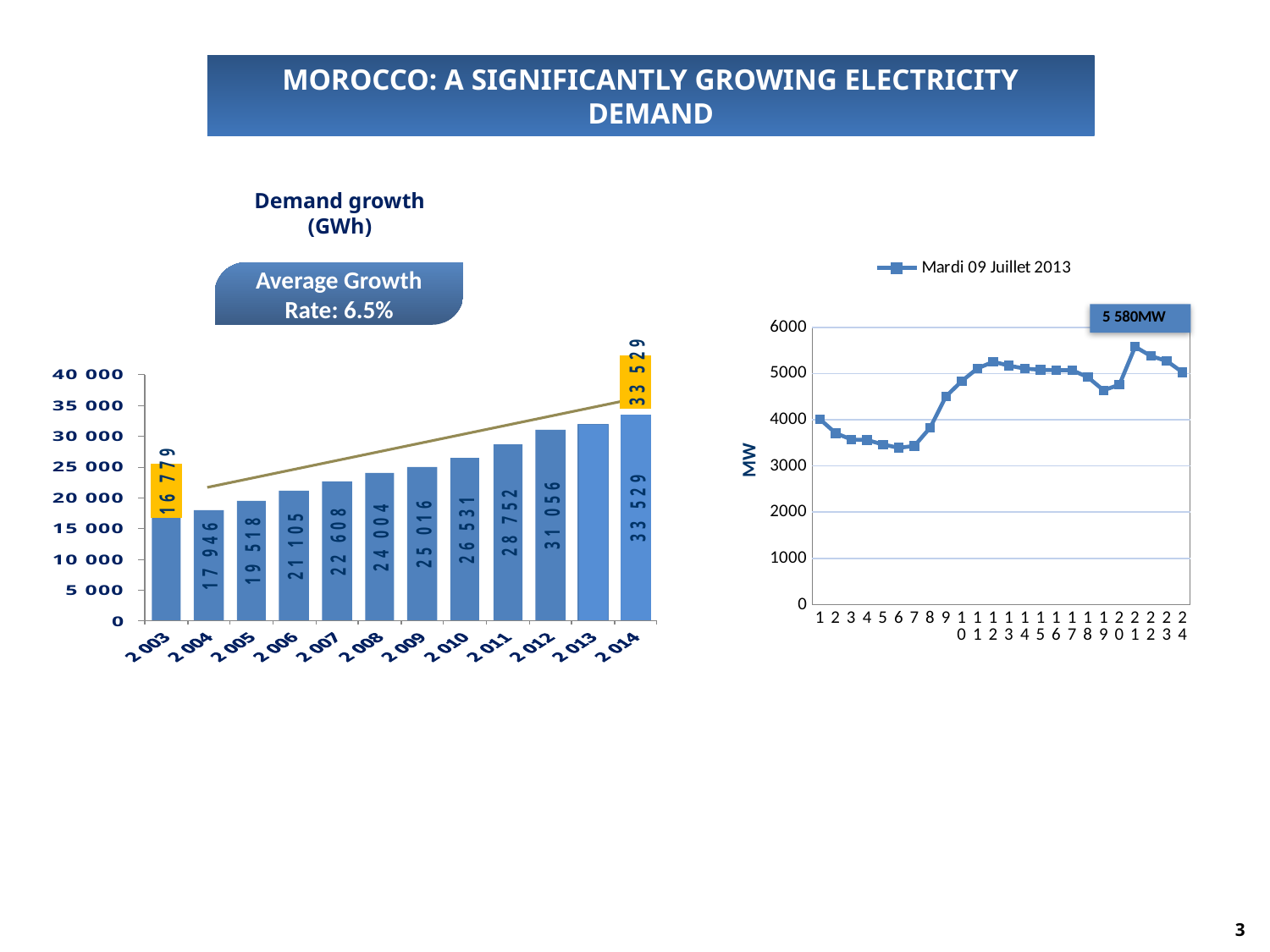
In the Demand growth (GWh) chart, what is the value for 2003? 16 779 In the line chart on the right, what peak value is labelled on the chart? 5 580MW In the Demand growth (GWh) chart, what is the value for 2014? 33 529 In the Demand growth (GWh) chart, what is the value for 2010? 26 531 In the Demand growth (GWh) chart, what is the difference between the 2014 and 2003 values? 16 750 How many years are shown in the Demand growth (GWh) chart? 12 What kind of chart is the Demand growth (GWh) chart? bar chart In the Demand growth (GWh) chart, do the values rise or fall from 2003 to 2014? rise In the Demand growth (GWh) chart, which is larger, the value for 2008 or for 2009? 2009 In the Demand growth (GWh) chart, which year has the highest demand? 2014 In the line chart on the right, is the value at hour 6 greater or less than 4000? less In the Demand growth (GWh) chart, which year has the lowest demand? 2003